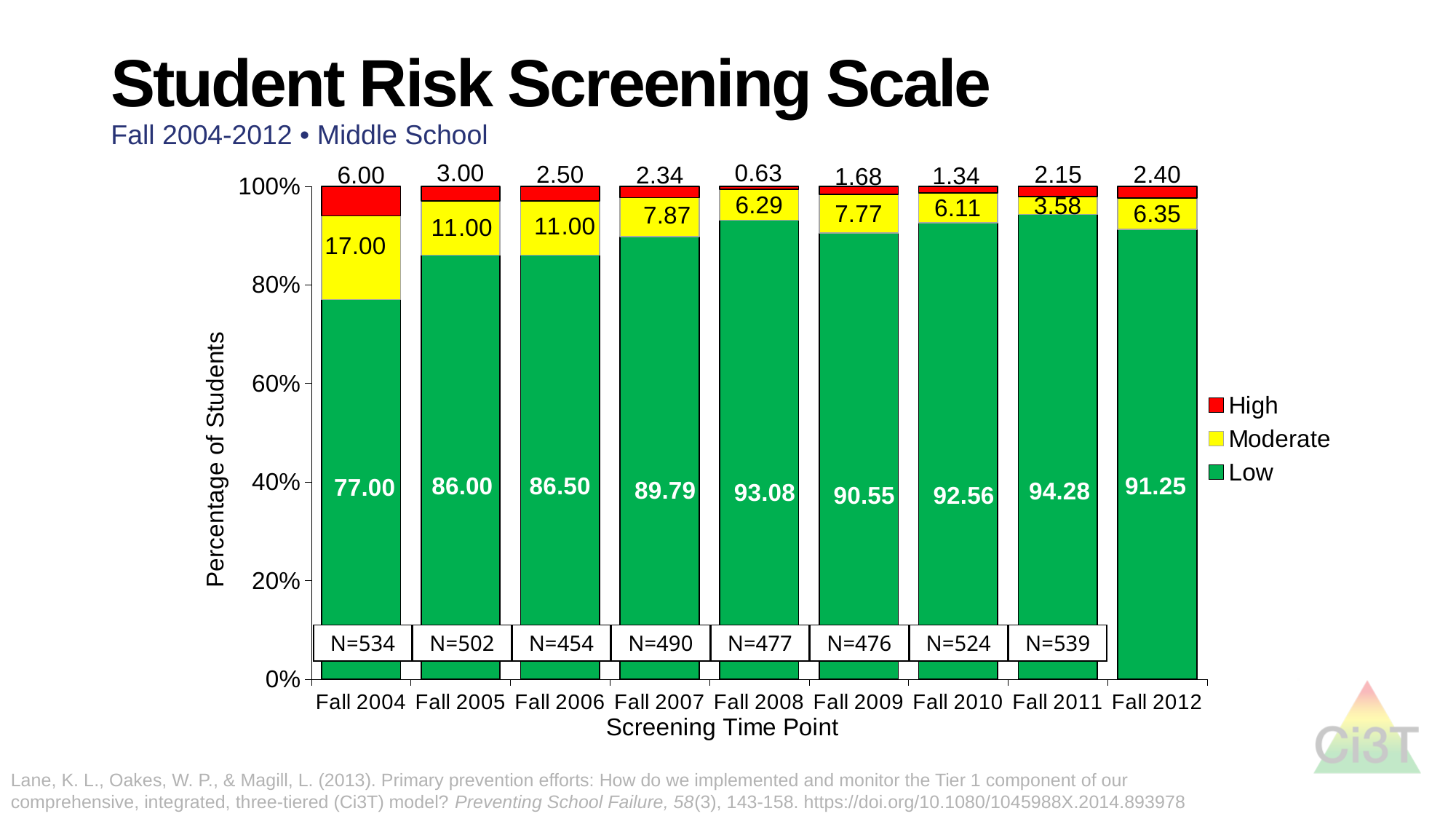
Which screening time point has the highest Low value? Fall 2011 Which screening time point has the lowest High value? Fall 2008 Which is larger, the Moderate value for Fall 2009 or the Moderate value for Fall 2010? Fall 2009 What is the difference between the Low value for Fall 2005 and the Low value for Fall 2004? 9.00 What is the total of the three segments for the Fall 2004 bar? 100.00 What is the High value for Fall 2008? 0.63 What is the sample size (N) shown for Fall 2011? N=539 What is the Low value for Fall 2004? 77.00 How many screening time points are shown on the x axis? 9 How many series does the legend list? 3 What is the Moderate value for Fall 2007? 7.87 What kind of chart is shown on the slide? Stacked bar chart